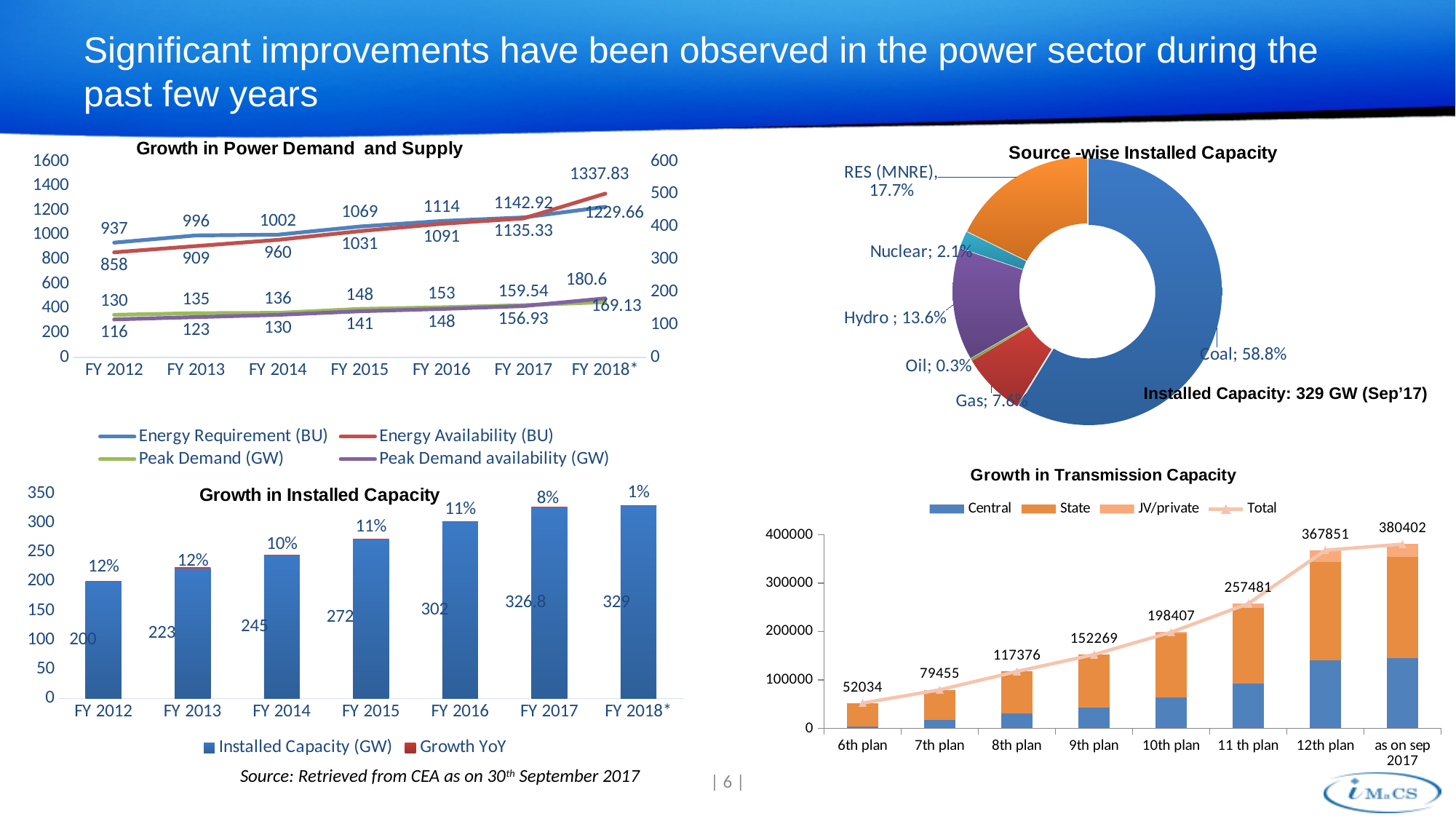
In the 'Growth in Transmission Capacity' chart, how many categories are shown on the x axis? 8 In the 'Growth in Transmission Capacity' chart, what is the Total for the 12th plan? 367851 In the 'Growth in Installed Capacity' chart, what is the Growth YoY for FY 2018*? 1% In the 'Growth in Power Demand and Supply' chart, what is the Energy Requirement (BU) value for FY 2012? 937 In the 'Source-wise Installed Capacity' chart, which source has the smallest share? Oil In the 'Growth in Power Demand and Supply' chart, what is the difference between Peak Demand (GW) and Peak Demand availability (GW) in FY 2015? 7 In the 'Growth in Power Demand and Supply' chart, how many series does the legend list? 4 In the 'Growth in Power Demand and Supply' chart, what is the Peak Demand availability (GW) value for FY 2017? 156.93 In the 'Growth in Installed Capacity' chart, what is the Installed Capacity (GW) for FY 2016? 302 In the 'Source-wise Installed Capacity' chart, which is larger, Hydro or RES (MNRE)? RES (MNRE) In the 'Growth in Installed Capacity' chart, what kind of chart is used? Bar chart In the 'Source-wise Installed Capacity' chart, what share does Coal have? 58.8%